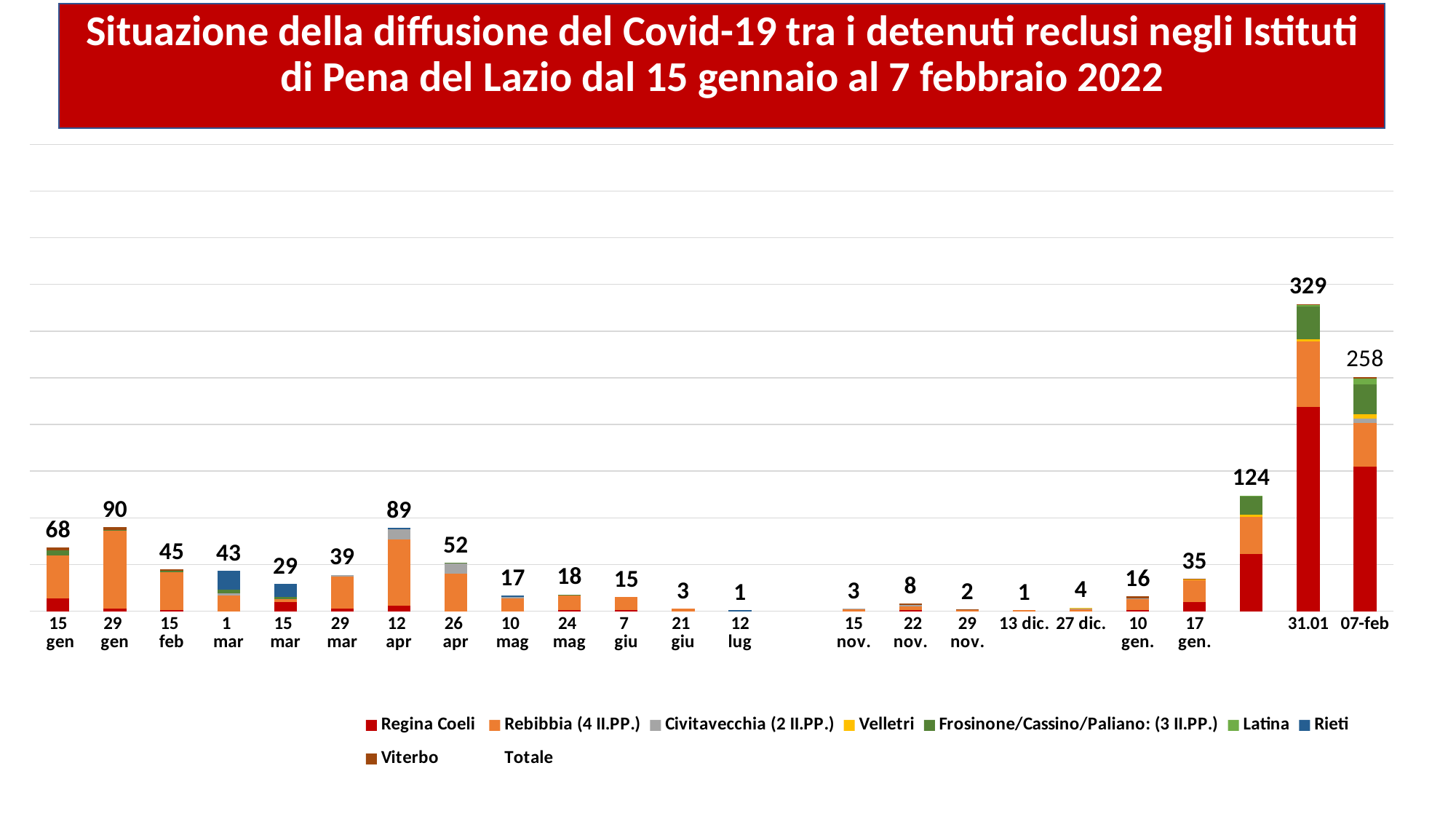
What is the total value shown for 15 gen? 68 What is the total value shown for 12 apr? 89 Which has a larger total, 29 gen or 12 apr? 29 gen What is the total value shown for 07-feb? 258 What kind of chart is shown on the slide? Stacked bar chart What is the total value shown for 31.01? 329 Which series is shown in dark red? Regina Coeli Between 10 gen. and 07-feb, do the totals generally rise or fall? Rise How many entries does the legend list? 9 What is the difference between the totals for 31.01 and 07-feb? 71 What is the difference between the totals for 29 gen and 15 gen? 22 Which date has the highest total? 31.01